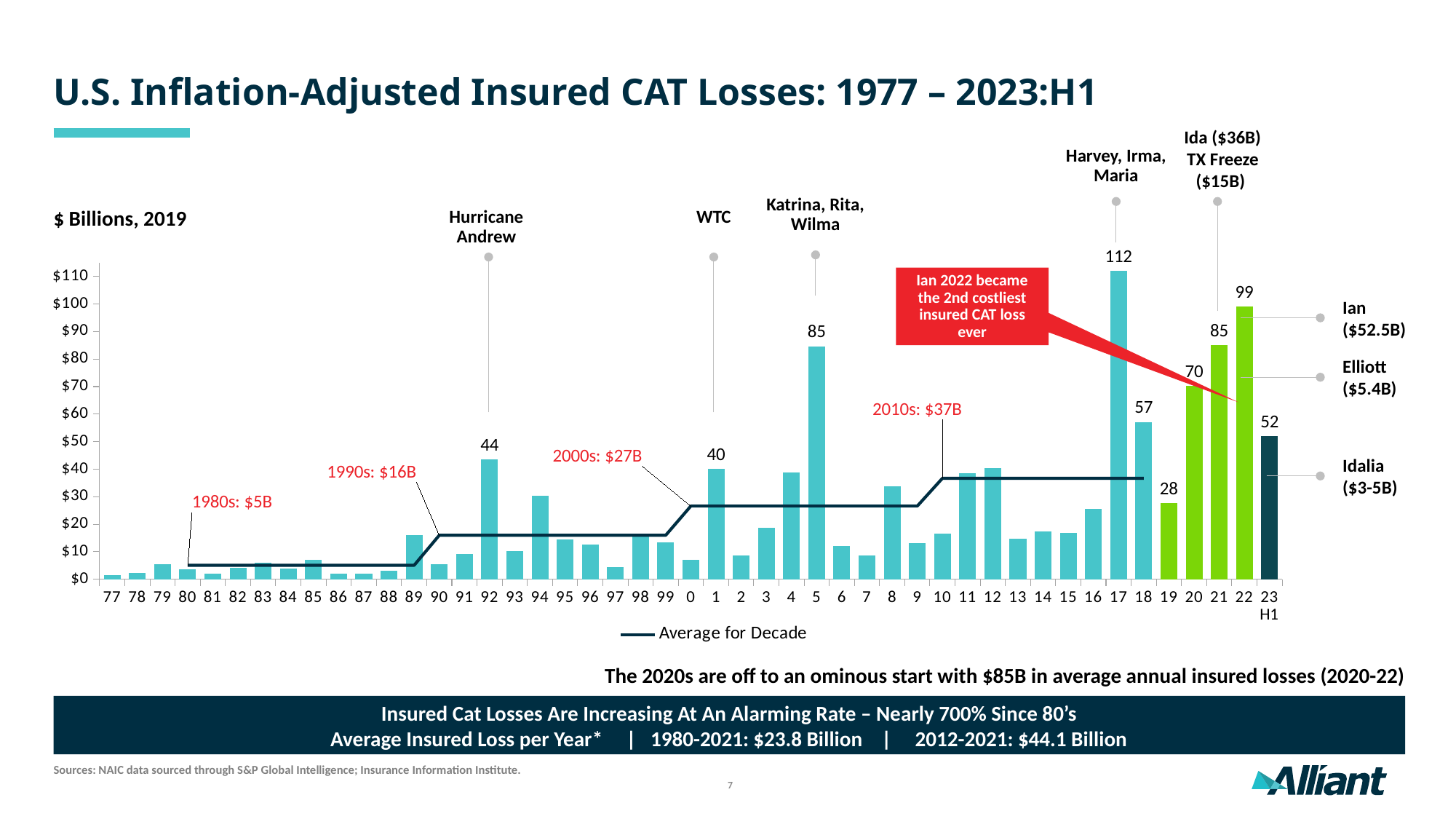
How many entries does the chart legend list? 1 Is the value for 1997 (97) greater or less than $10? less Is the value for 1994 (94) greater or less than $20? greater What is the value for 2022 (22) on the chart? 99 What is the average for the 1990s decade shown on the chart? $16B What is the difference between the values for 2022 and 2021? 14 What kind of chart is shown on the slide? bar chart Which year has the highest insured CAT loss on the chart? 2017 (17) Which is larger, the value for 2018 or the value for 2019? 2018 What is the value for 2017 (17) on the chart? 112 What is the title of the chart? U.S. Inflation-Adjusted Insured CAT Losses: 1977 – 2023:H1 What is the difference between the values for 2017 and 2018? 55